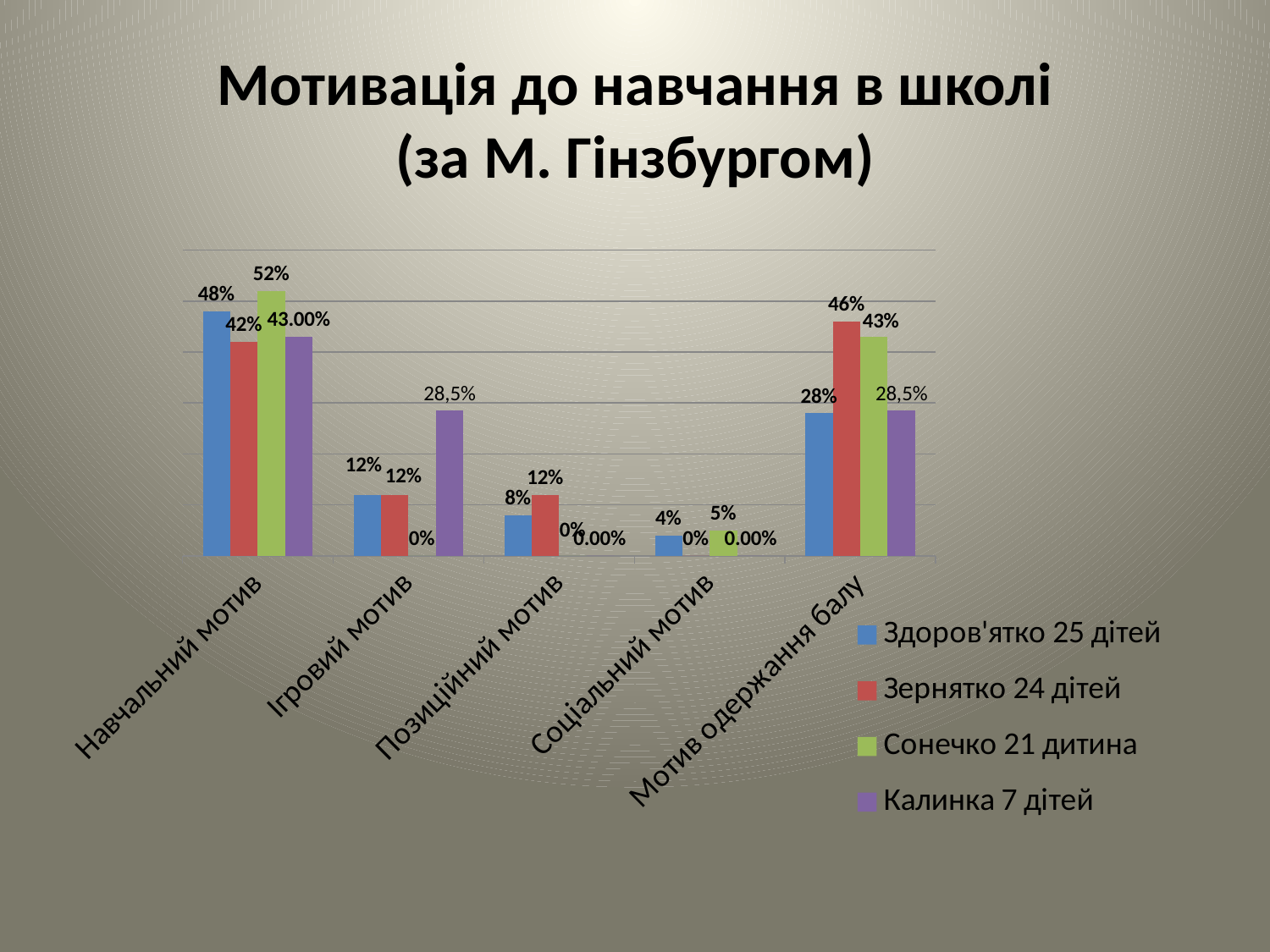
Which series has the highest value in the Навчальний мотив category? Сонечко 21 дитина What is the value for Зернятко 24 дітей in the Мотив одержання балу category? 46% What kind of chart is shown on the slide? Bar chart In the Позиційний мотив category, which is larger: the value for Здоров'ятко 25 дітей or for Зернятко 24 дітей? Зернятко 24 дітей What is the difference between the Зернятко 24 дітей and Здоров'ятко 25 дітей values in the Мотив одержання балу category? 18% What colour represents Калинка 7 дітей in the chart? Purple What is the value for Здоров'ятко 25 дітей in the Навчальний мотив category? 48% How many series does the legend list? 4 Which series has the lowest value in the Мотив одержання балу category? Здоров'ятко 25 дітей What is the value for Калинка 7 дітей in the Ігровий мотив category? 28,5% How many categories are shown on the x axis? 5 What is the value for Сонечко 21 дитина in the Навчальний мотив category? 52%